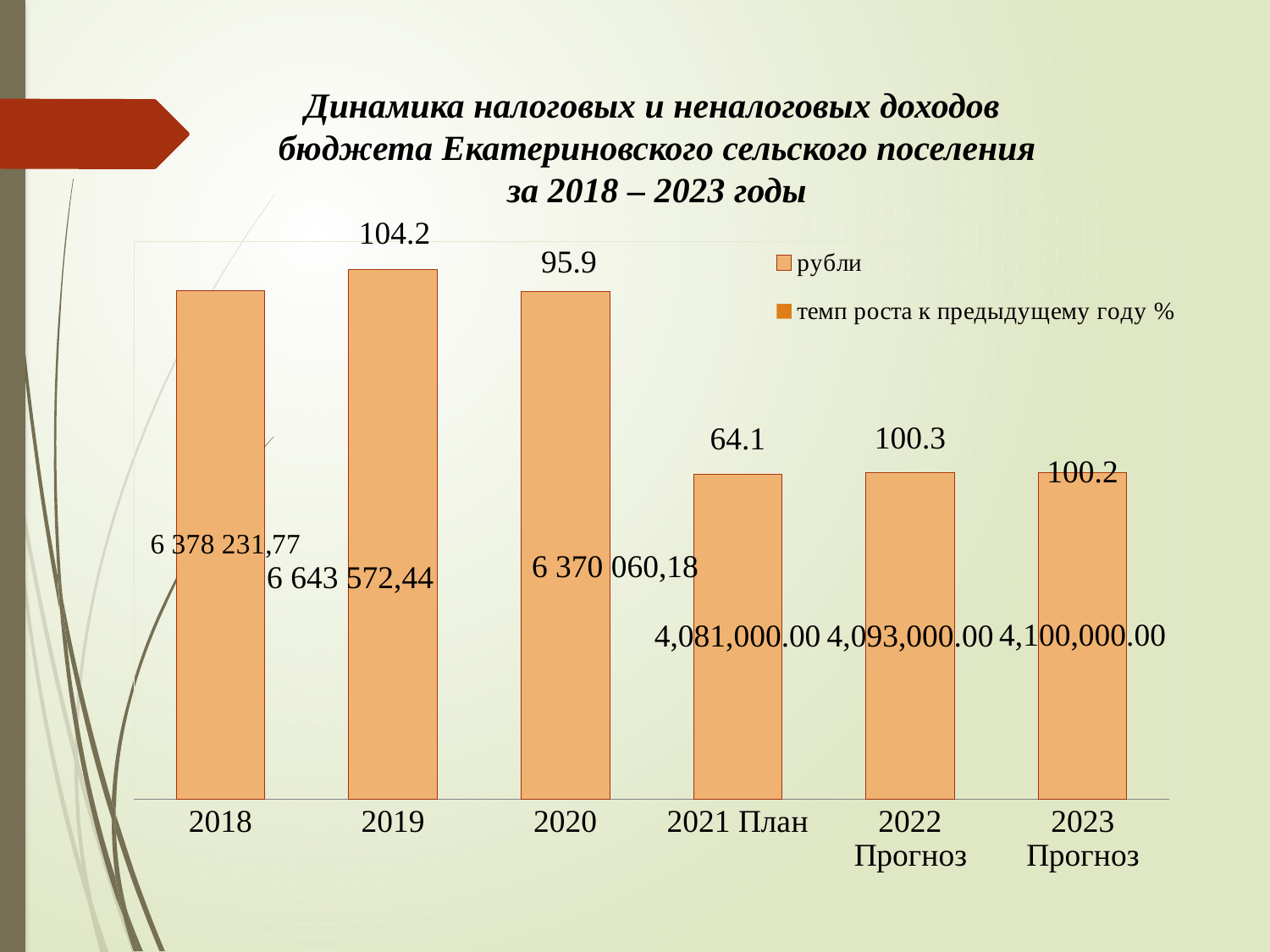
Which category has the lowest value in rubles? 2021 План How many categories are shown on the x axis? 6 What is the growth rate to the previous year (%) for 2019? 104.2 What is the value in rubles for 2019? 6 643 572,44 What is the growth rate to the previous year (%) for 2021 План? 64.1 Which year has the highest value in rubles? 2019 Which is larger in rubles, 2018 or 2020? 2018 How many series does the legend list? 2 What is the value in rubles for 2021 План? 4,081,000.00 What is the difference in rubles between 2023 Прогноз and 2022 Прогноз? 7,000.00 What is the value in rubles for 2018? 6 378 231,77 What type of chart is shown on the slide? bar chart